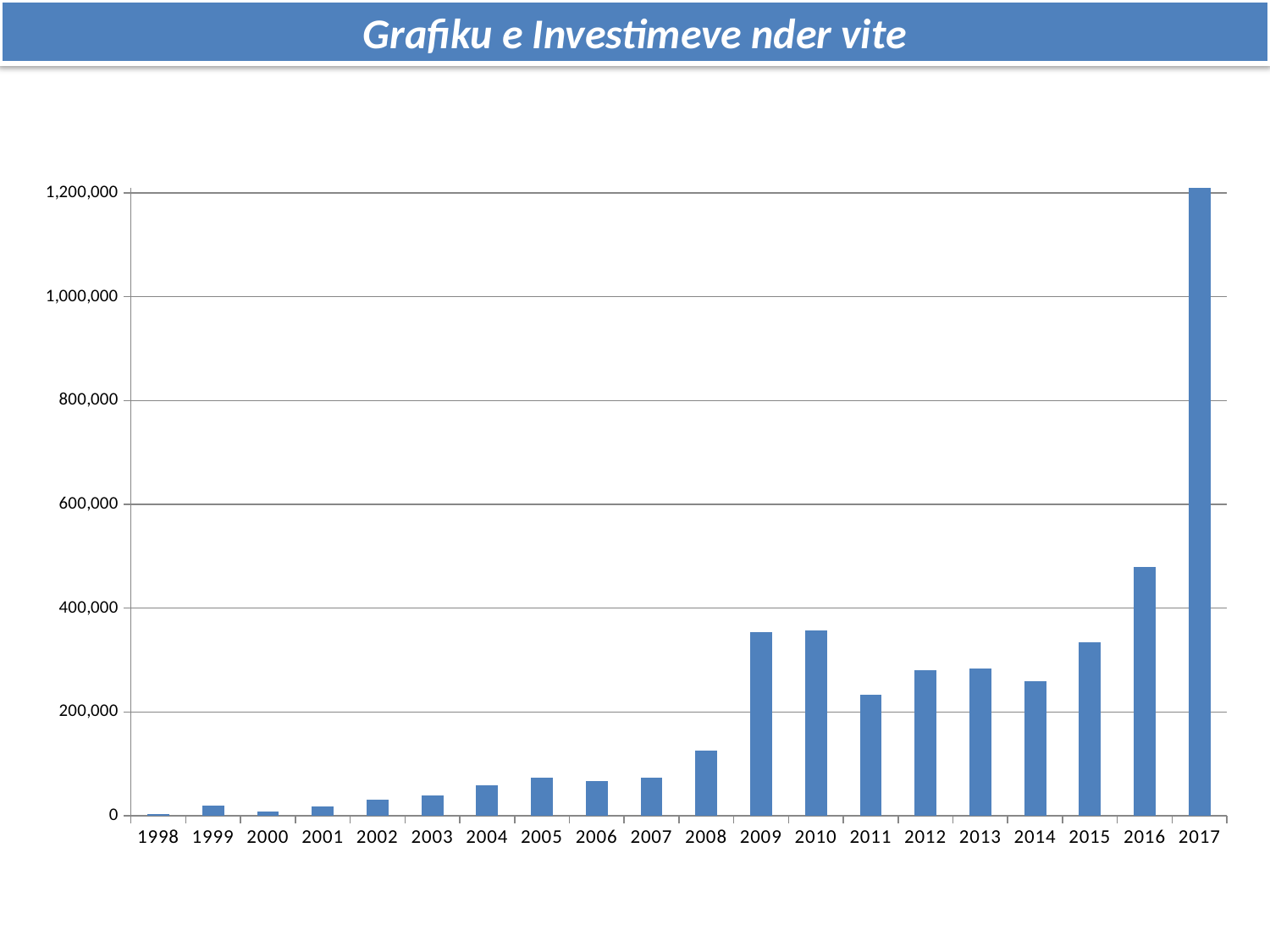
Which year has the larger value, 2011 or 2012? 2012 Is the value for 2016 greater or less than 400,000? greater What kind of chart is shown on the slide? bar chart Is the value for 2008 greater or less than 200,000? less Which year has the lowest value in the chart? 1998 What is the title of the chart? Grafiku e Investimeve nder vite How many years are shown on the x axis of the chart? 20 Is the value for 2017 greater or less than 1,000,000? greater Do the values generally rise or fall from 1998 to 2017? rise Which year has the highest value in the chart? 2017 Which year has the larger value, 2015 or 2016? 2016